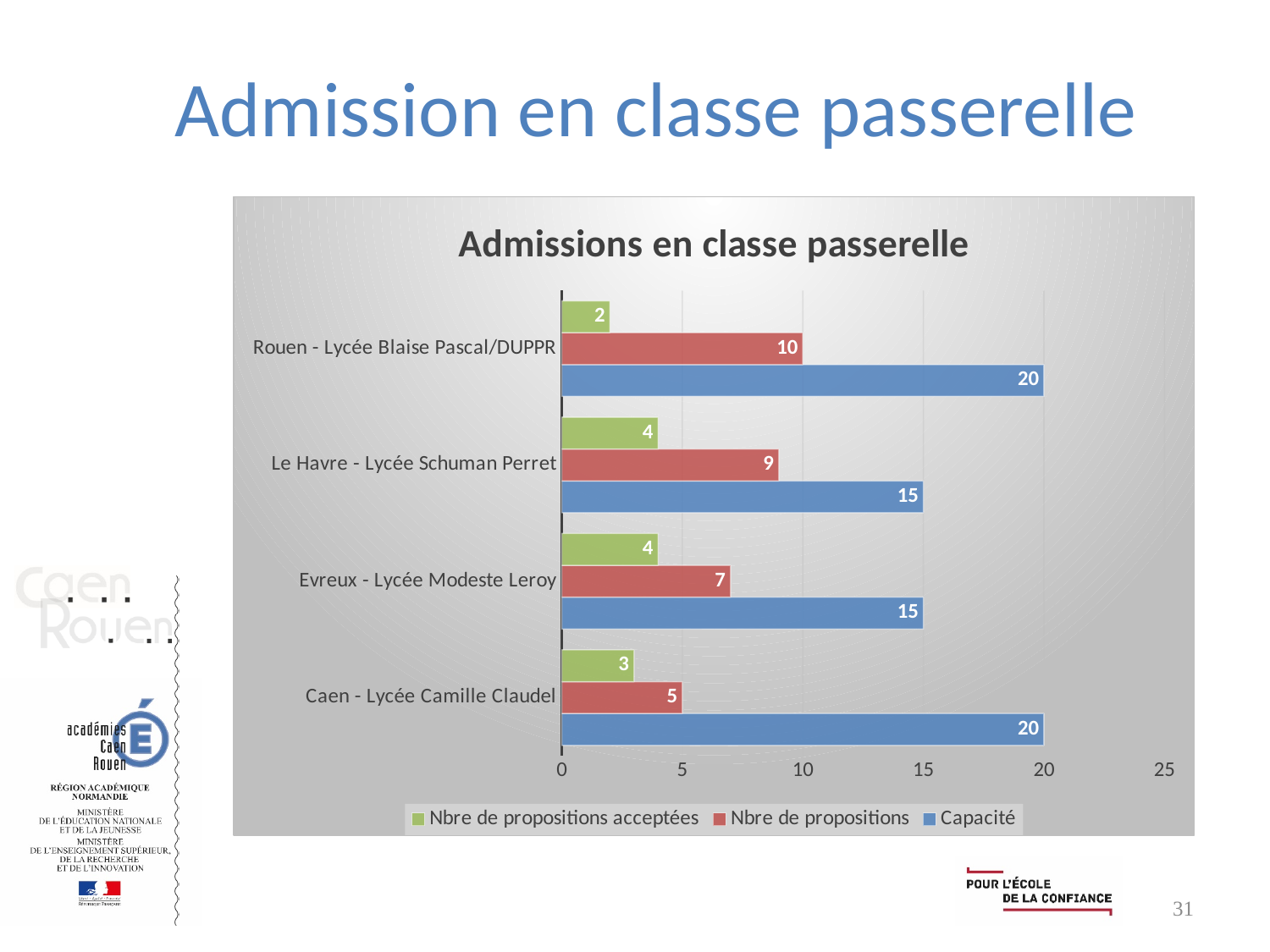
Which category has the lowest Nbre de propositions acceptées? Rouen - Lycée Blaise Pascal/DUPPR What is the Nbre de propositions value for Le Havre - Lycée Schuman Perret? 9 What is the Capacité value for Rouen - Lycée Blaise Pascal/DUPPR? 20 Which colour represents the Capacité series? Blue What is the title of the chart? Admissions en classe passerelle Which category has the lowest Nbre de propositions? Caen - Lycée Camille Claudel What is the difference between Capacité and Nbre de propositions for Caen - Lycée Camille Claudel? 15 What kind of chart is shown on the slide? Bar chart Which is larger: the Nbre de propositions for Rouen - Lycée Blaise Pascal/DUPPR or for Evreux - Lycée Modeste Leroy? Rouen - Lycée Blaise Pascal/DUPPR What is the Nbre de propositions acceptées value for Caen - Lycée Camille Claudel? 3 How many categories (lycées) are shown on the chart? 4 How many series does the legend list? 3